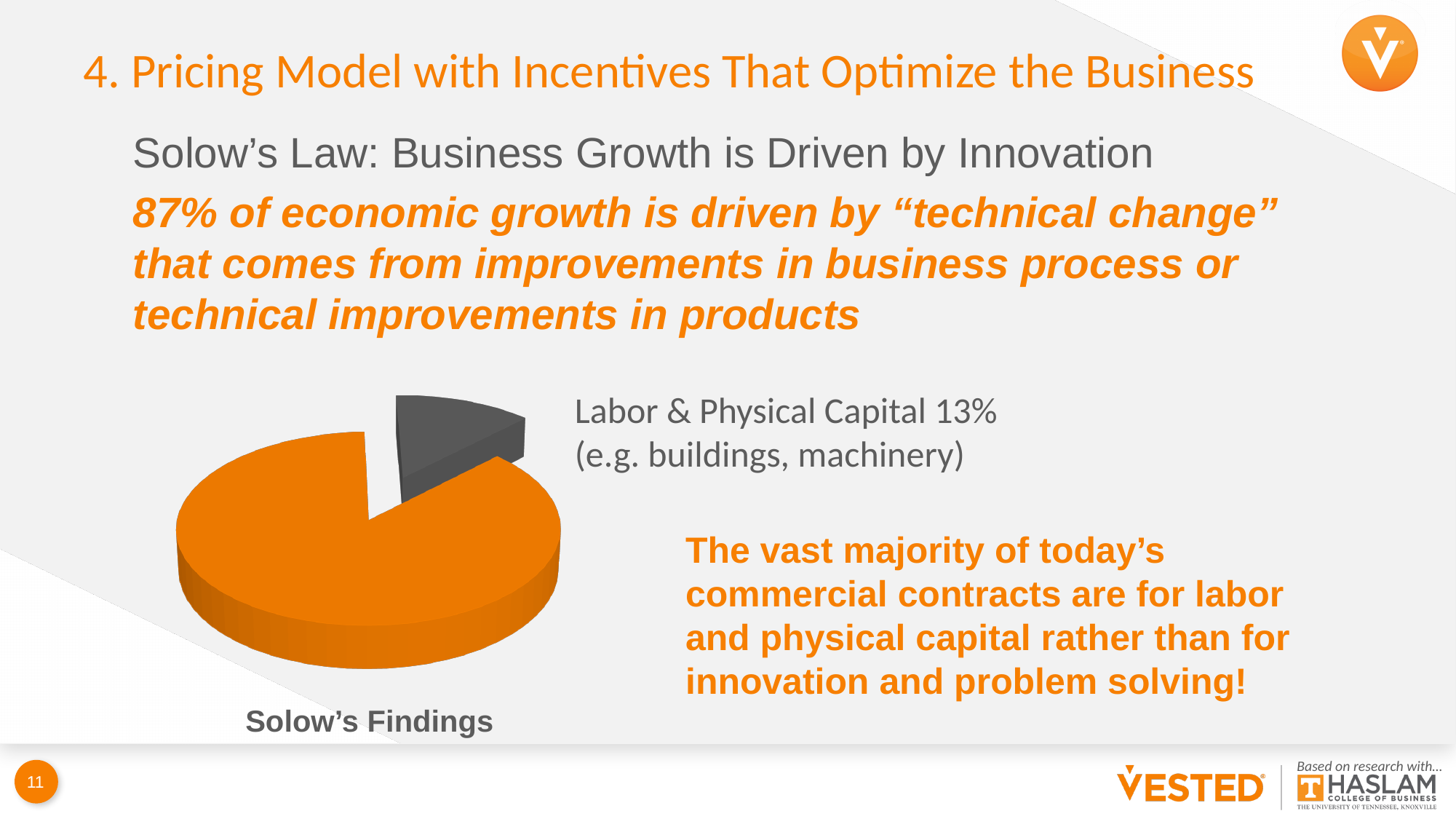
What is the difference in percentage points between the technical change share (87%) and the Labor & Physical Capital share (13%)? 74 What colour is the Labor & Physical Capital slice in the pie chart? grey According to the slide, what percentage of economic growth is driven by technical change? 87% Is the Labor & Physical Capital slice more or less than half of the pie? less What percentage is shown for Labor & Physical Capital? 13% How many slices does the pie chart have? 2 Which is larger in the pie chart: the orange slice or the grey slice? the orange slice What is the title of the chart on the slide? Solow's Findings What kind of chart is shown on the slide? pie chart What share of the pie is labelled Labor & Physical Capital? 13% Which slice of the pie chart is the smallest? Labor & Physical Capital